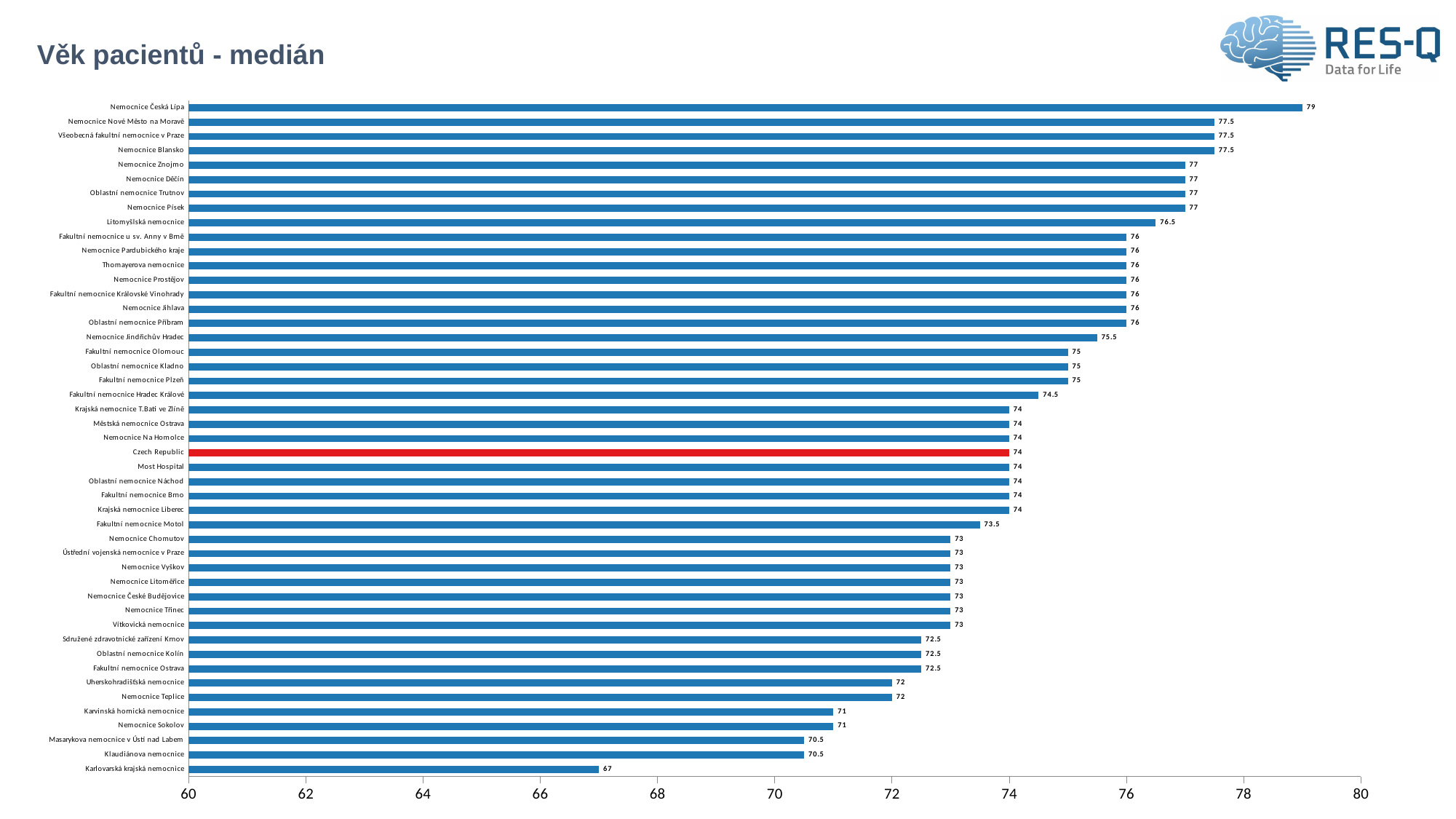
What is the difference between the median patient age of Nemocnice Česká Lípa and Karlovarská krajská nemocnice? 12 Which bar is highlighted in red? Czech Republic What is the title of the chart? Věk pacientů - medián What is the difference between the median patient age of Fakultní nemocnice Hradec Králové and Czech Republic? 0.5 Which hospital has the lowest median patient age? Karlovarská krajská nemocnice What type of chart is shown on the slide? Bar chart What is the median patient age for Karlovarská krajská nemocnice? 67 Which hospital has the highest median patient age? Nemocnice Česká Lípa Is the value for Litomyšlská nemocnice greater or less than 76? greater Which has a higher median patient age, Nemocnice Blansko or Nemocnice Teplice? Nemocnice Blansko What is the median patient age for Czech Republic? 74 What is the median patient age for Fakultní nemocnice Motol? 73.5